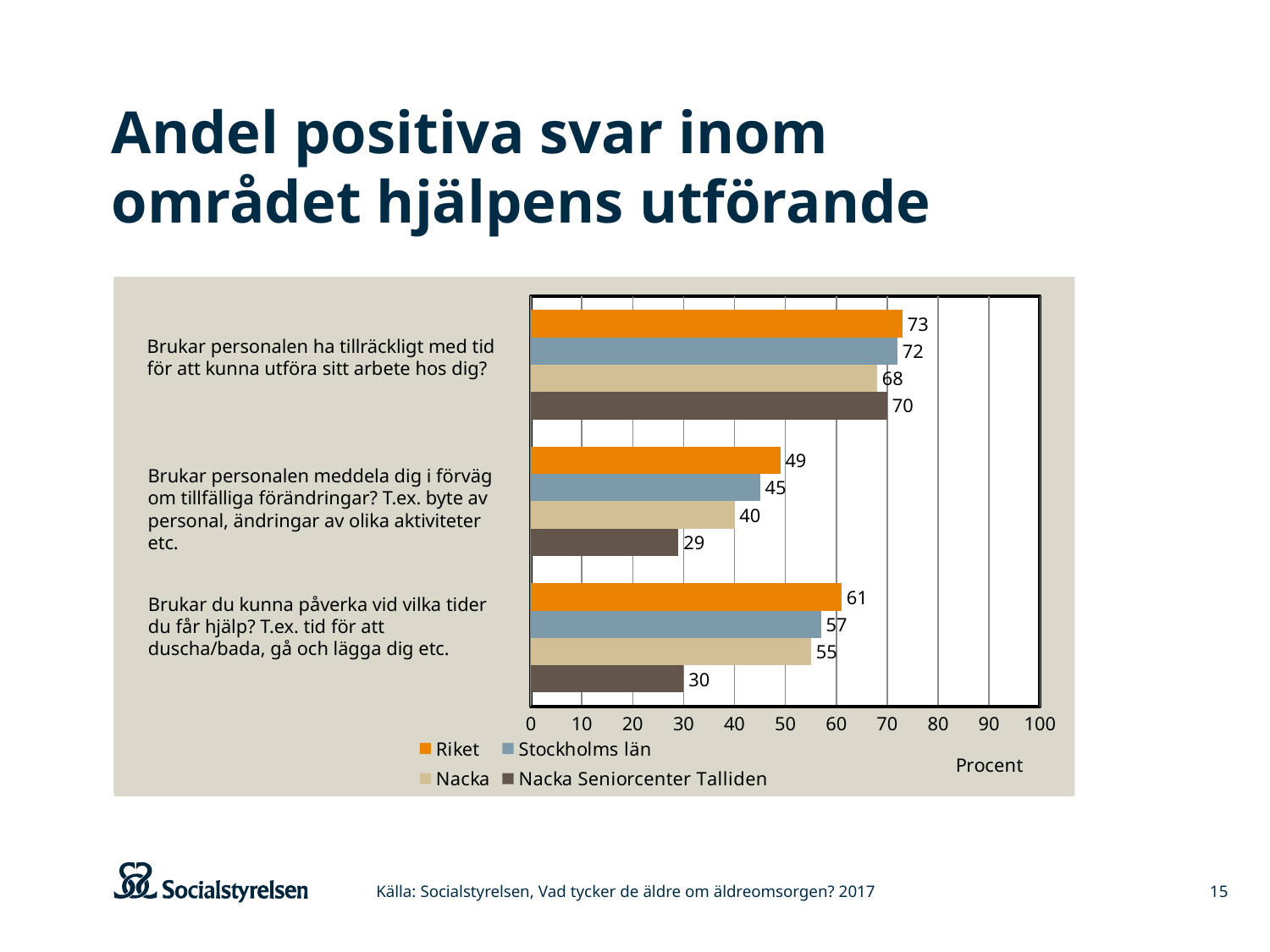
What kind of chart is shown on the slide? Bar chart What is the label on the horizontal axis of the chart? Procent What is the difference between Nacka and Nacka Seniorcenter Talliden on the question "Brukar personalen ha tillräckligt med tid för att kunna utföra sitt arbete hos dig?"? 2 Which is larger on the question "Brukar personalen meddela dig i förväg om tillfälliga förändringar?": Stockholms län or Nacka? Stockholms län How many series does the legend list? 4 What is the value for Nacka Seniorcenter Talliden on the question "Brukar personalen meddela dig i förväg om tillfälliga förändringar?"? 29 How many questions (categories) are shown on the chart? 3 What is the difference between Riket and Nacka Seniorcenter Talliden on the question "Brukar du kunna påverka vid vilka tider du får hjälp?"? 31 What is the value for Stockholms län on the question "Brukar du kunna påverka vid vilka tider du får hjälp?"? 57 Which series has the highest value on the question "Brukar personalen meddela dig i förväg om tillfälliga förändringar?"? Riket Which series has the lowest value on the question "Brukar du kunna påverka vid vilka tider du får hjälp?"? Nacka Seniorcenter Talliden What is the value for Riket on the question "Brukar personalen ha tillräckligt med tid för att kunna utföra sitt arbete hos dig?"? 73